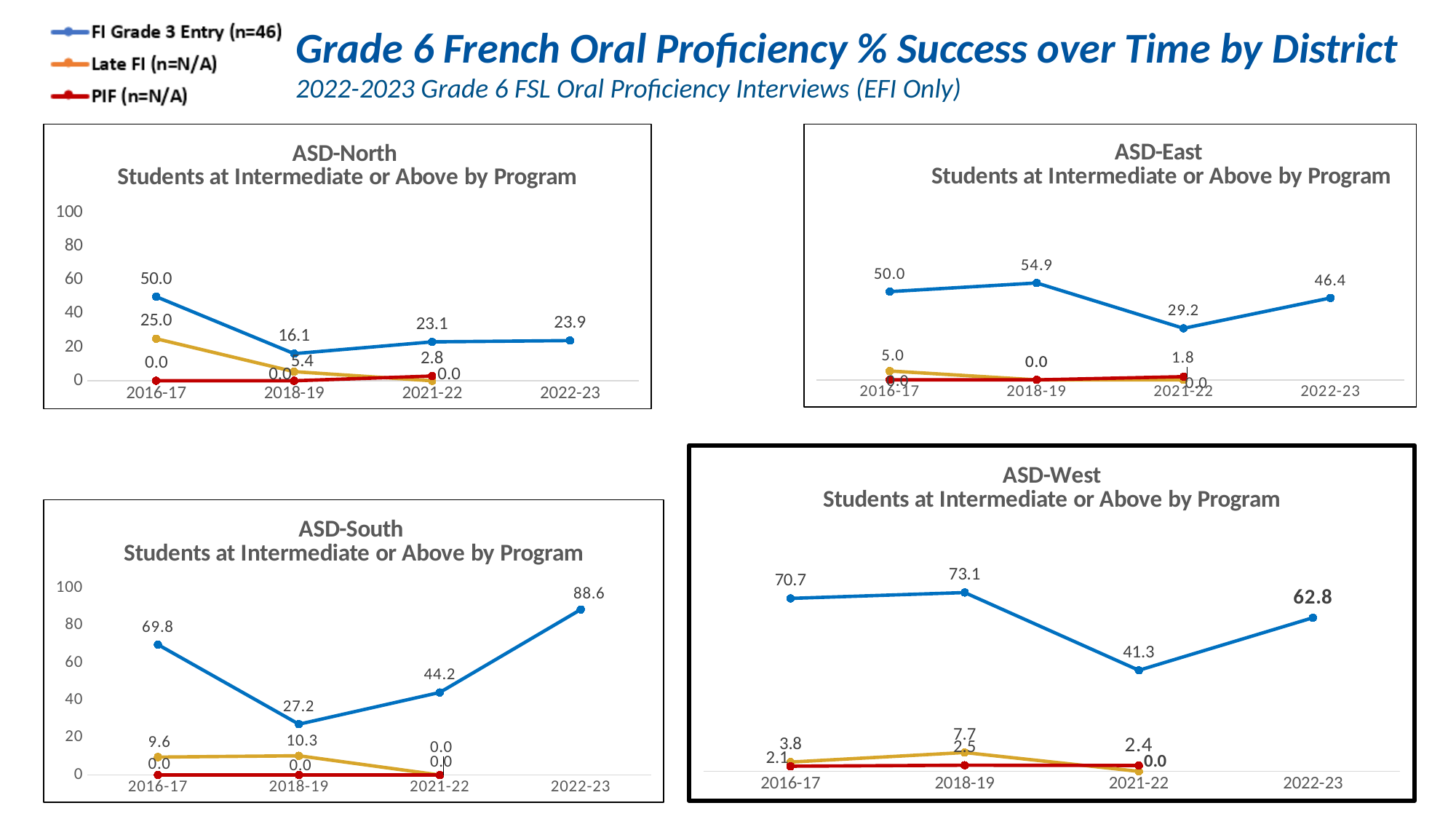
In the ASD-North chart, what is the Late FI value for 2016-17? 25.0 In the ASD-East chart, what is the Late FI value for 2016-17? 5.0 In the ASD-South chart, what is the difference between the FI Grade 3 Entry values for 2022-23 and 2021-22? 44.4 In the ASD-East chart, what is the FI Grade 3 Entry value for 2022-23? 46.4 In the ASD-North chart, what is the FI Grade 3 Entry value for 2016-17? 50.0 How many years are shown on the x axis of the ASD-North chart? 4 What kind of chart is the ASD-South chart? line chart In the ASD-East chart, which year has the highest FI Grade 3 Entry value? 2018-19 In the ASD-West chart, what is the FI Grade 3 Entry value for 2021-22? 41.3 In the ASD-South chart, which year has the lowest FI Grade 3 Entry value? 2018-19 How many series does the legend list? 3 In the ASD-West chart, is the FI Grade 3 Entry value for 2016-17 larger or smaller than the value for 2018-19? smaller